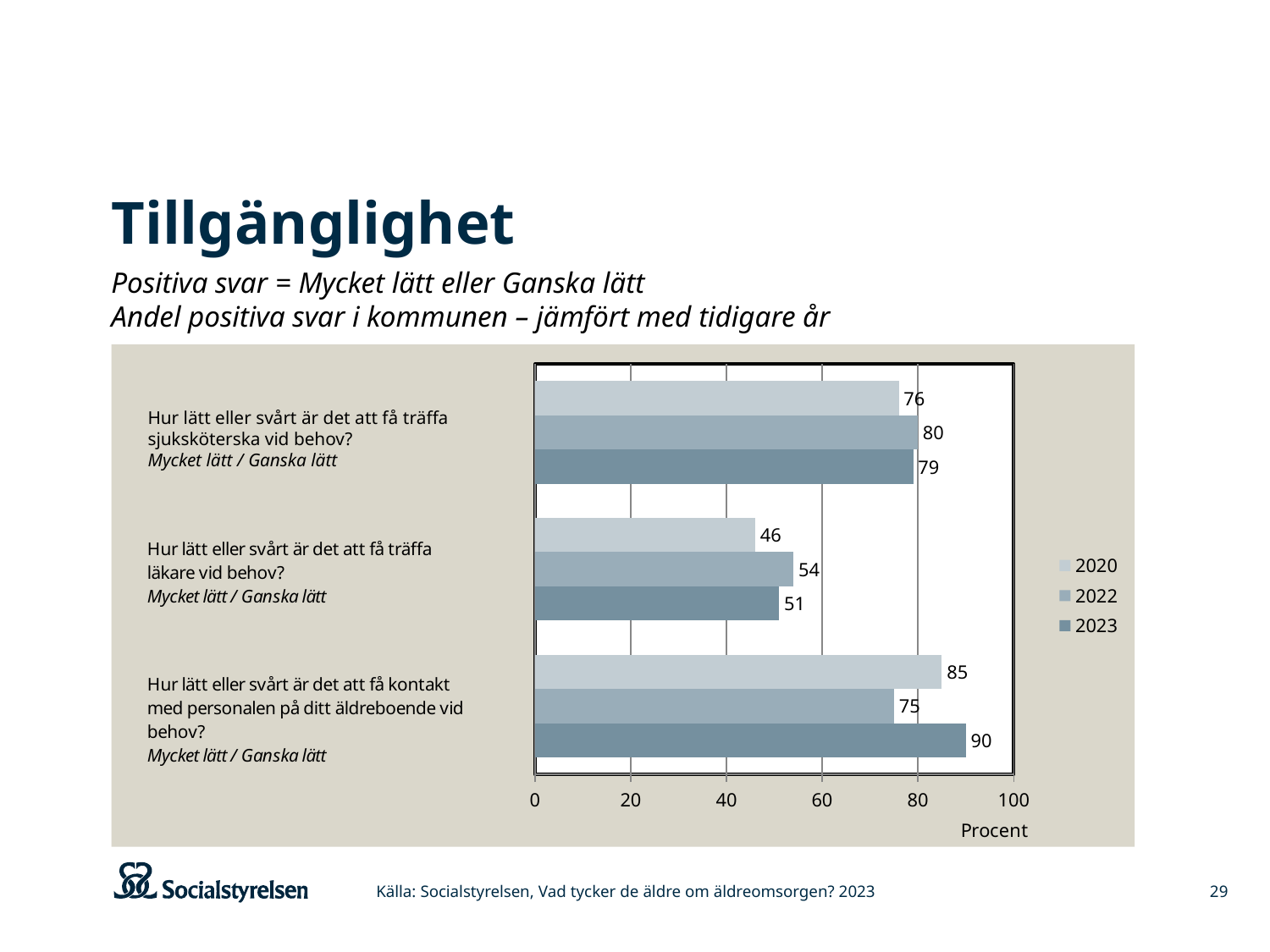
What kind of chart is shown on the slide? bar chart How many series does the legend list? 3 What is the difference between the 2022 and 2020 values for "Hur lätt eller svårt är det att få träffa sjuksköterska vid behov?"? 4 What is the 2023 value for "Hur lätt eller svårt är det att få träffa sjuksköterska vid behov?"? 79 What is the 2020 value for "Hur lätt eller svårt är det att få träffa läkare vid behov?"? 46 What is the difference between the 2023 and 2022 values for "Hur lätt eller svårt är det att få kontakt med personalen på ditt äldreboende vid behov?"? 15 Which question category has the lowest 2020 value? Hur lätt eller svårt är det att få träffa läkare vid behov? How many question categories are plotted in the chart? 3 Which question category has the highest 2023 value? Hur lätt eller svårt är det att få kontakt med personalen på ditt äldreboende vid behov? What is the 2022 value for "Hur lätt eller svårt är det att få kontakt med personalen på ditt äldreboende vid behov?"? 75 What is the label on the x axis of the chart? Procent For "Hur lätt eller svårt är det att få träffa läkare vid behov?", which year has the larger value, 2022 or 2023? 2022